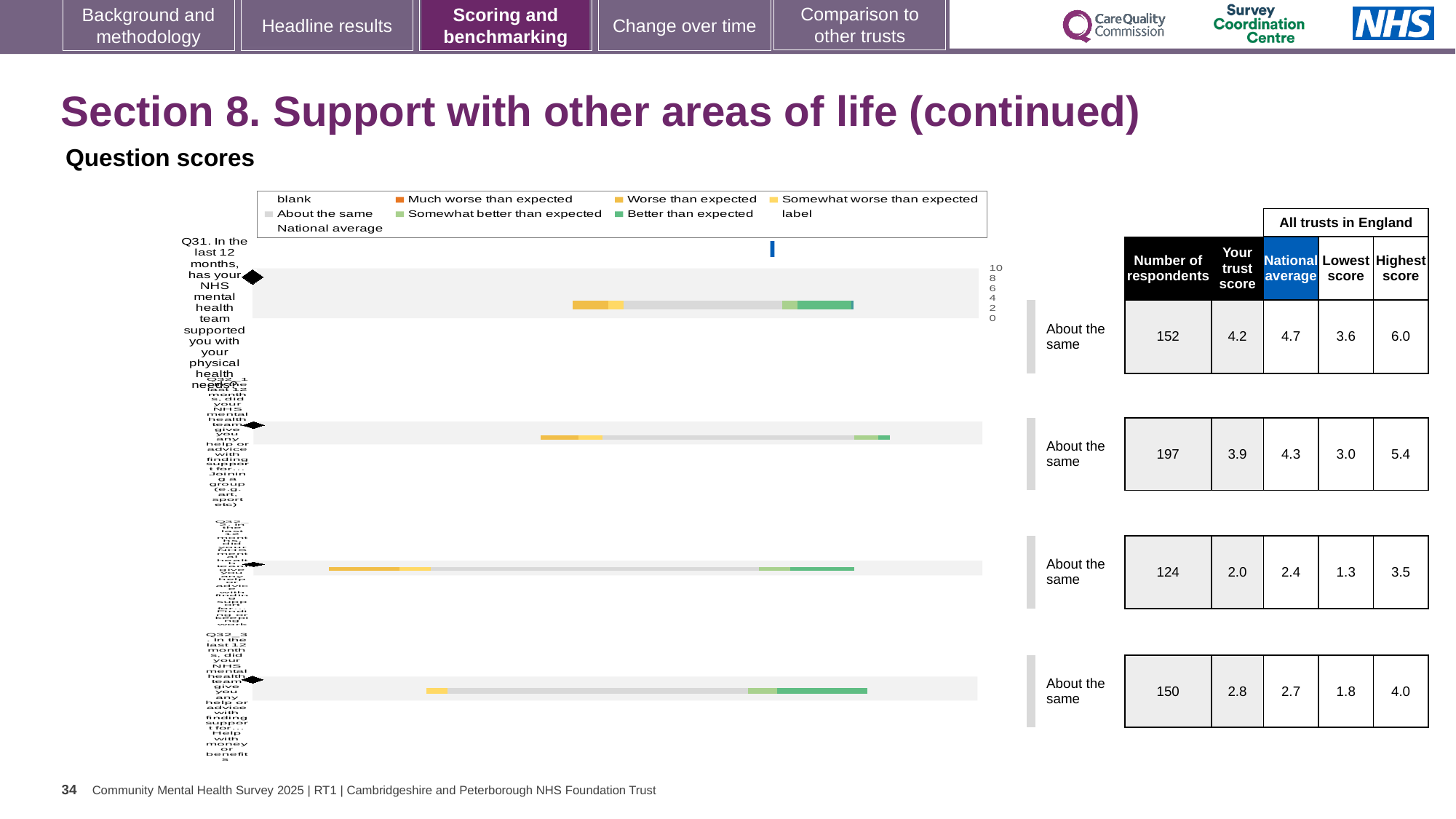
For Q31 (support with physical health needs), how many respondents are shown? 152 Which question row has the largest number of respondents? The second row (Q32_1), with 197 What is the national average for Q31 (support with physical health needs)? 4.7 What benchmark category is shown for every question row on this slide? About the same How many questions (rows) are plotted in the question scores chart? 4 For Q31, which is larger: the trust's score or the national average? National average What is the trust's score for Q31 (support with physical health needs)? 4.2 What type of chart is used to show the question scores on this slide? bar chart What is the highest score among all trusts in England for Q31? 6.0 What is the highest value shown on the chart's score axis? 10 For Q31, what is the difference between the highest score and the lowest score across all trusts in England? 2.4 What is the trust's score for the fourth (bottom) question row, Q32_3 (help with money or benefits)? 2.8